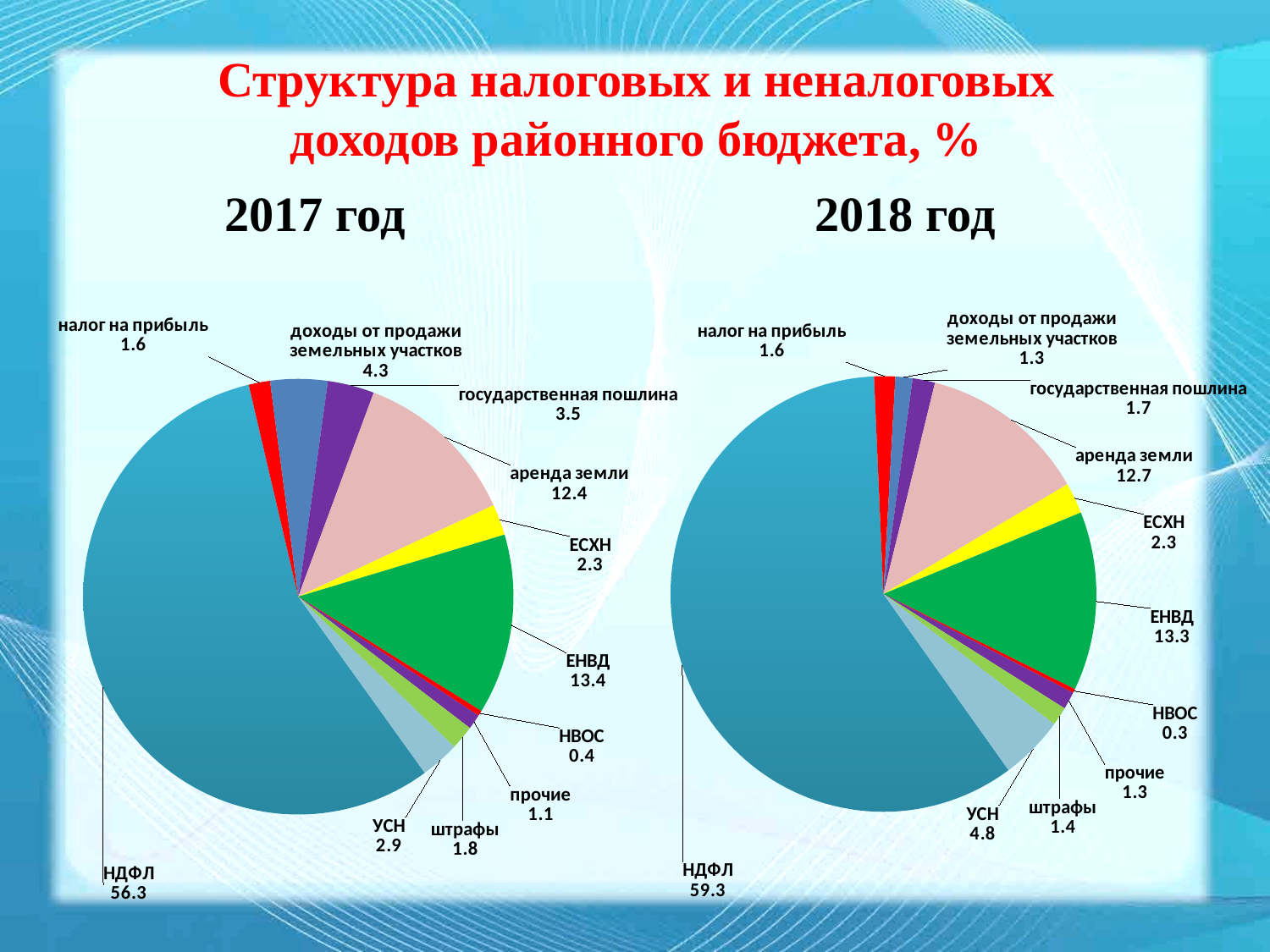
How many categories are shown in the 2018 год chart? 11 In the 2017 год chart, which is larger: аренда земли or ЕНВД? ЕНВД In the 2018 год chart, which category has the smallest share? НВОС In the 2017 год chart, what is the difference between ЕНВД and ЕСХН? 11.1 In the 2017 год chart, which category has the largest share? НДФЛ What is the title of the slide? Структура налоговых и неналоговых доходов районного бюджета, % What is the difference between the НДФЛ values in the 2018 год chart and the 2017 год chart? 3.0 In the 2018 год chart, what is the value for УСН? 4.8 In the 2017 год chart, what is the value for НДФЛ? 56.3 In the 2017 год chart, which category has the smallest share? НВОС In the 2018 год chart, what is the value for ЕНВД? 13.3 What kind of chart is used for the 2017 год data? pie chart